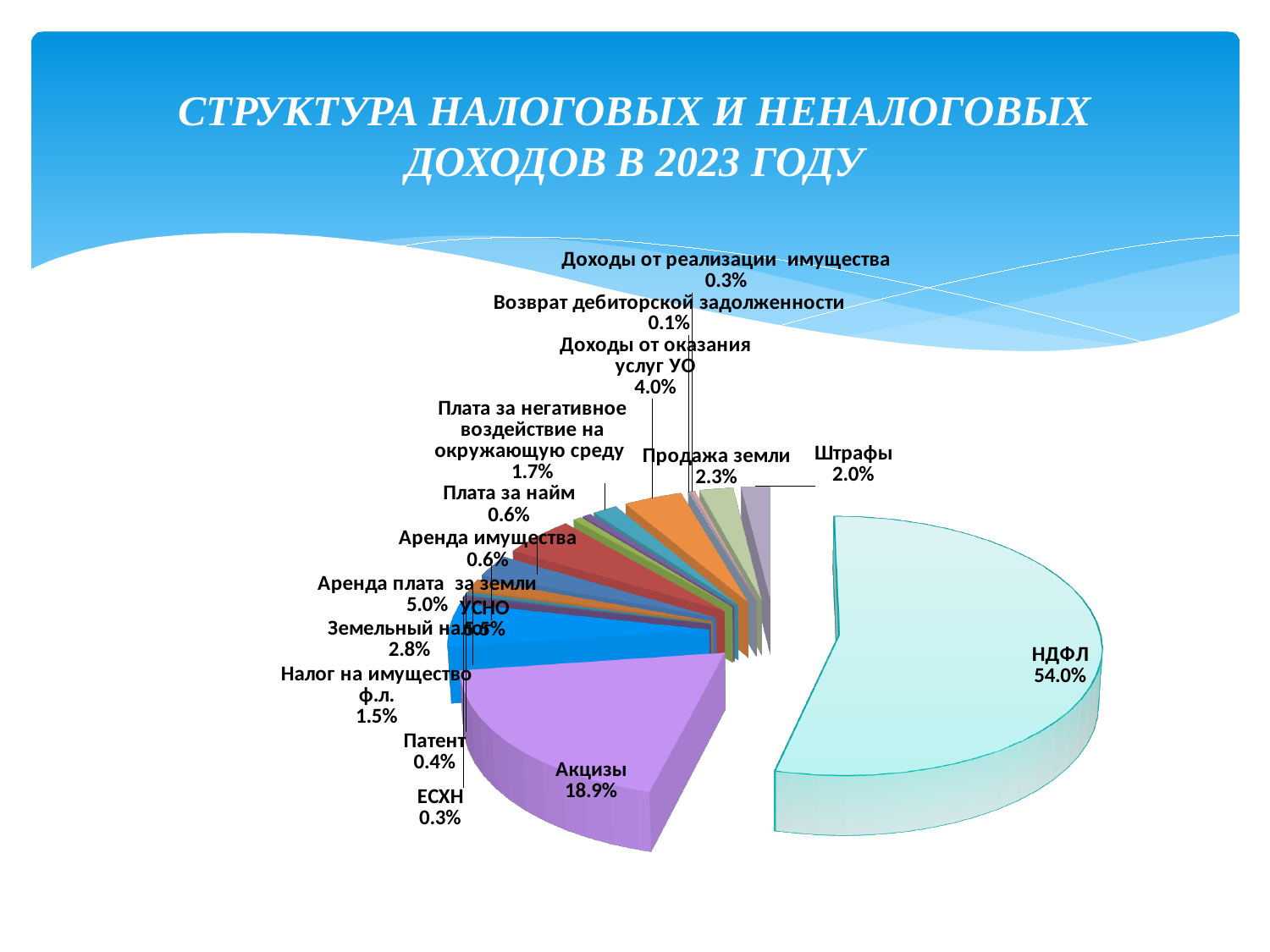
What is the title of the slide? СТРУКТУРА НАЛОГОВЫХ И НЕНАЛОГОВЫХ ДОХОДОВ В 2023 ГОДУ Which is larger, the share for Продажа земли or the share for Штрафы? Продажа земли What share of the pie does НДФЛ account for? 54.0% Which category has the smallest share of the pie? Возврат дебиторской задолженности What is the value shown for Доходы от оказания услуг УО? 4.0% What is the value shown for Аренда плата за земли? 5.0% What is the difference between the shares of НДФЛ and Акцизы? 35.1% What is the value shown for Штрафы? 2.0% What is the value shown for Акцизы? 18.9% What kind of chart is shown on the slide? pie chart What is the value shown for Плата за негативное воздействие на окружающую среду? 1.7% Which category has the largest share of the pie? НДФЛ